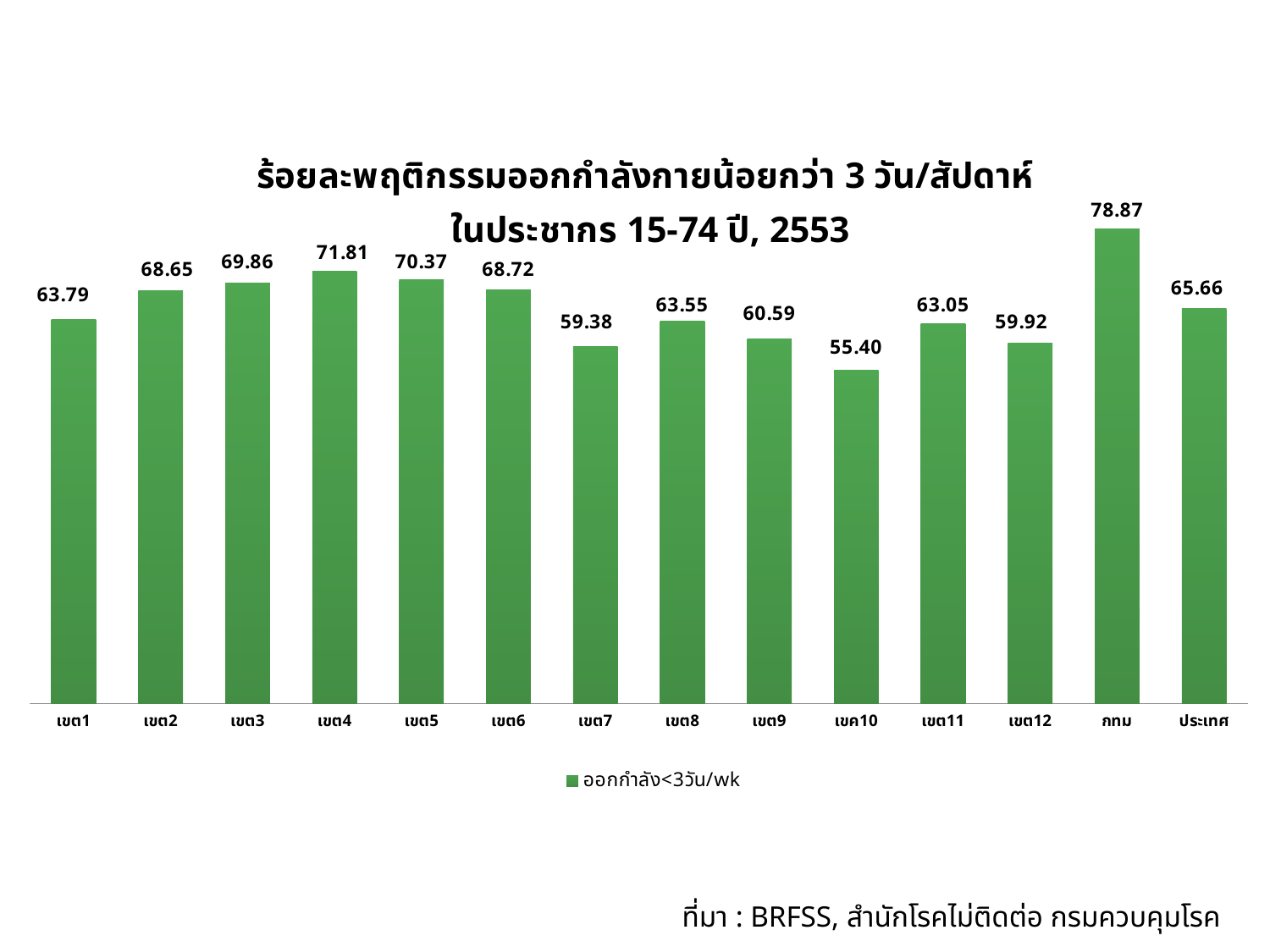
Which is larger, the value for เขต3 or the value for เขต7? เขต3 What is the difference between the values for เขต4 and ประเทศ? 6.15 What is the difference between the values for กทม and เขค10? 23.47 What is the value for กทม? 78.87 How many categories are shown on the x axis? 14 Which category has the highest value? กทม What is the legend entry for the series? ออกกำลัง<3วัน/wk How many series does the legend list? 1 What is the value for เขต4? 71.81 Which category has the lowest value? เขค10 What type of chart is shown on the slide? bar chart What is the value for ประเทศ? 65.66